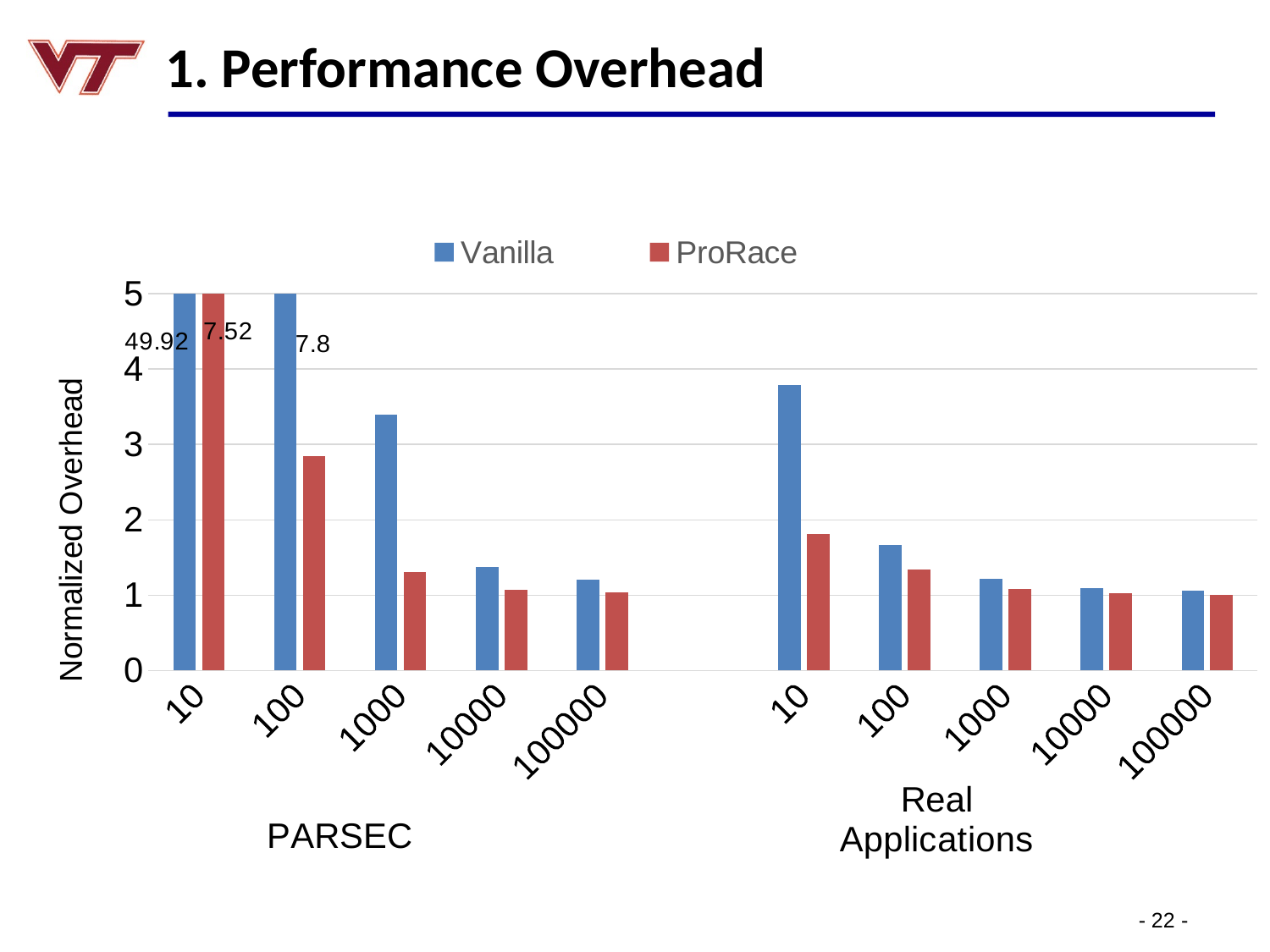
Which series has the larger value for 10 in the PARSEC group, Vanilla or ProRace? Vanilla How many x-axis categories are in the PARSEC group? 5 How many series does the legend list? 2 What is the Vanilla value for 10 in the PARSEC group? 49.92 What is the ProRace value for 10 in the PARSEC group? 7.52 Is the ProRace value for 1000 in the PARSEC group greater or less than 2? less Do the Vanilla values rise or fall from 10 to 100000 in the PARSEC group? fall What is the difference between the Vanilla and ProRace values for 10 in the PARSEC group? 42.40 What kind of chart is shown on the slide? Bar chart What is the title of the y axis? Normalized Overhead Is the Vanilla value for 10 in the Real Applications group greater or less than 3? greater What is the Vanilla value for 100 in the PARSEC group? 7.8